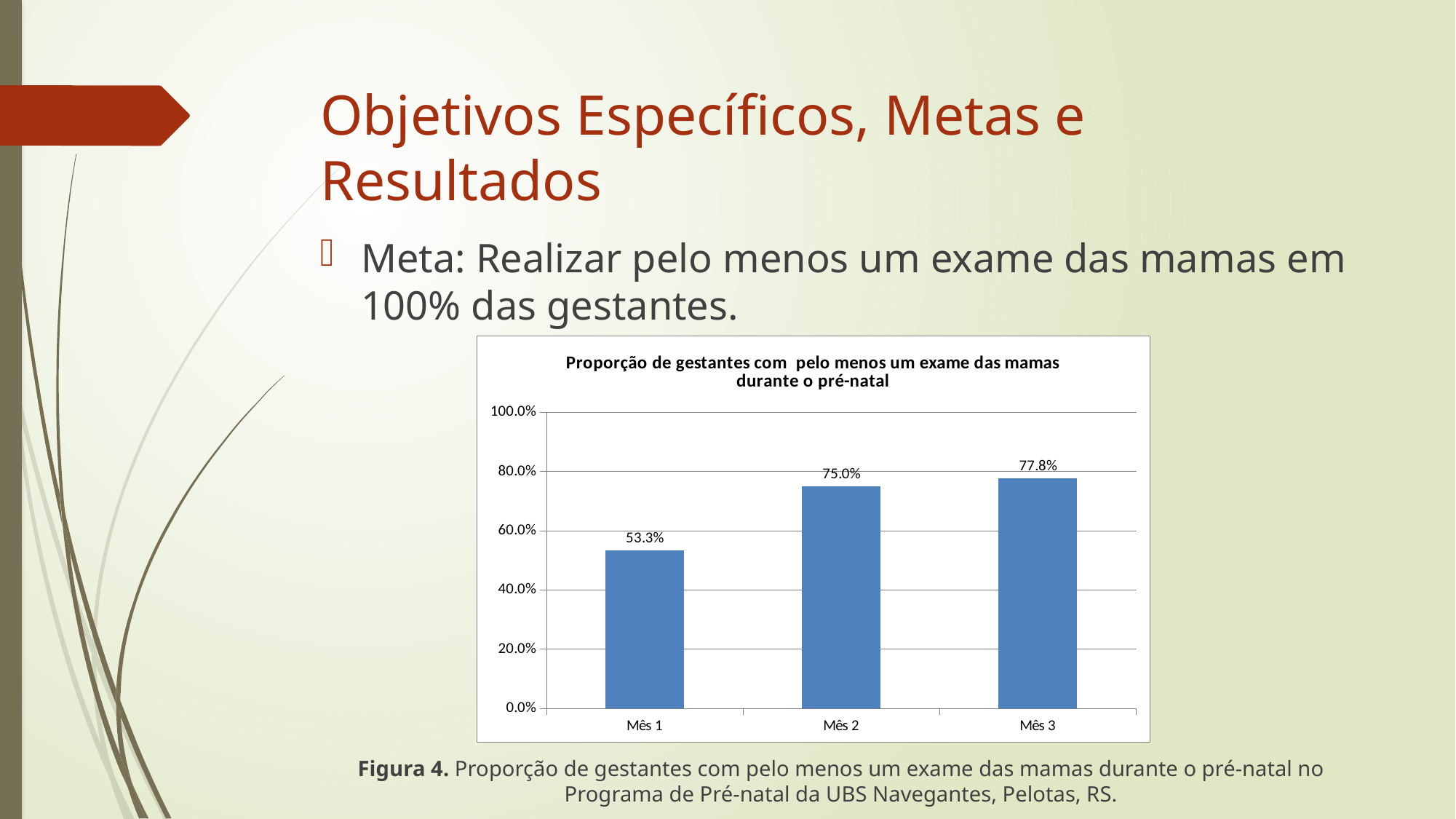
Which is larger, the value for Mês 1 or the value for Mês 2? Mês 2 Is the value for Mês 1 greater or less than 60.0%? less How many months are shown on the x axis? 3 Which month has the highest proportion? Mês 3 What is the value for Mês 1? 53.3% What kind of chart is shown? bar chart What is the difference between the values for Mês 2 and Mês 1? 21.7% What is the value for Mês 2? 75.0% What is the difference between the values for Mês 3 and Mês 2? 2.8% What is the value for Mês 3? 77.8% Do the values rise or fall from Mês 1 to Mês 3? rise Which month has the lowest proportion? Mês 1